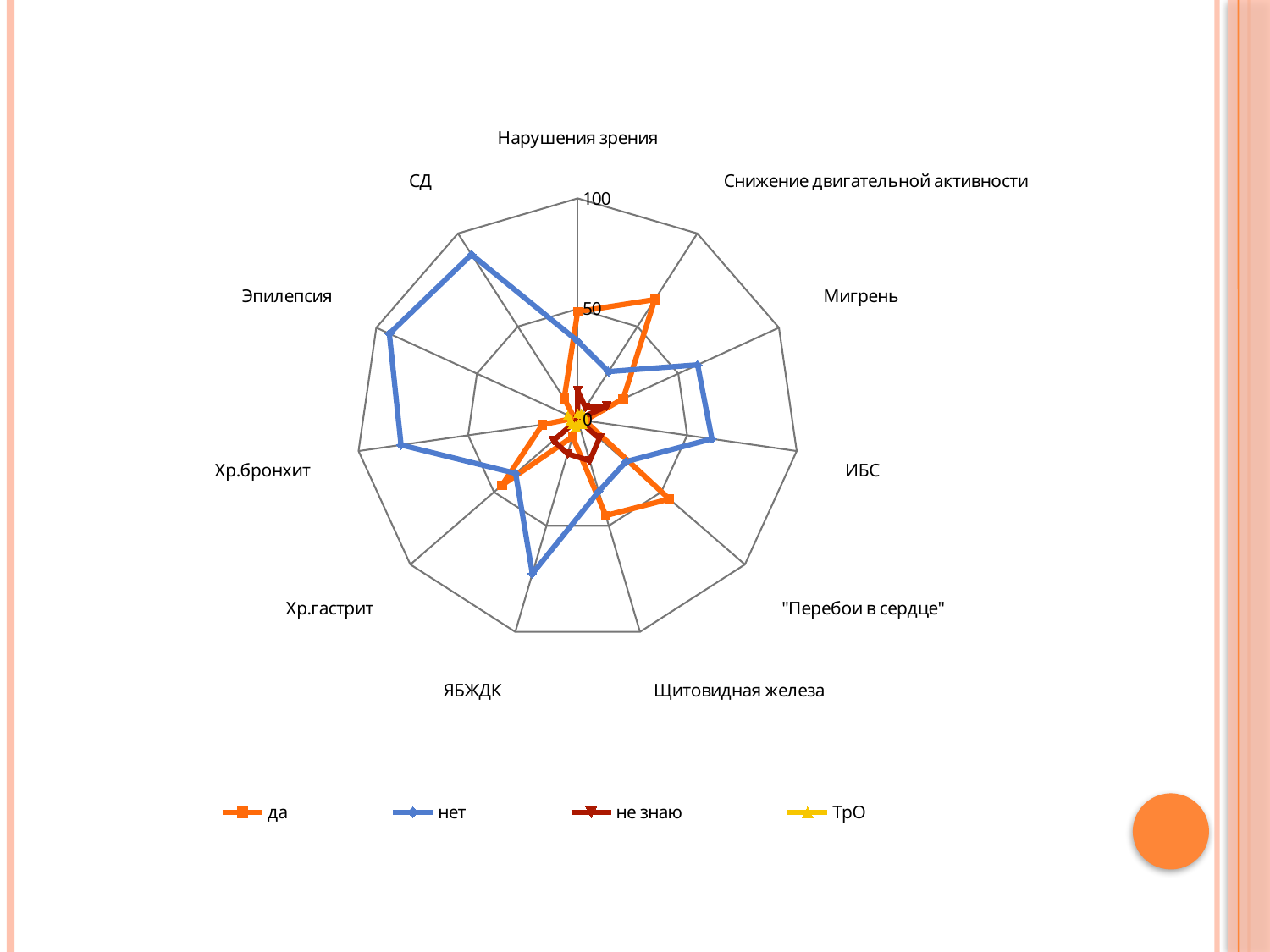
Is the value of the 'нет' series for Мигрень greater or less than 50? greater Is the value of the 'не знаю' series for Щитовидная железа greater or less than 50? less How many categories (axes) does the radar chart have? 11 For Хр.бронхит, which series has the larger value, 'да' or 'нет'? нет Is the value of the 'нет' series for Хр.гастрит greater or less than 50? less For Эпилепсия, which series has the larger value, 'да' or 'нет'? нет Which series is drawn in blue? нет How many series does the legend list? 4 What is the maximum value shown on the radial axis? 100 What kind of chart is shown on the slide? Radar chart